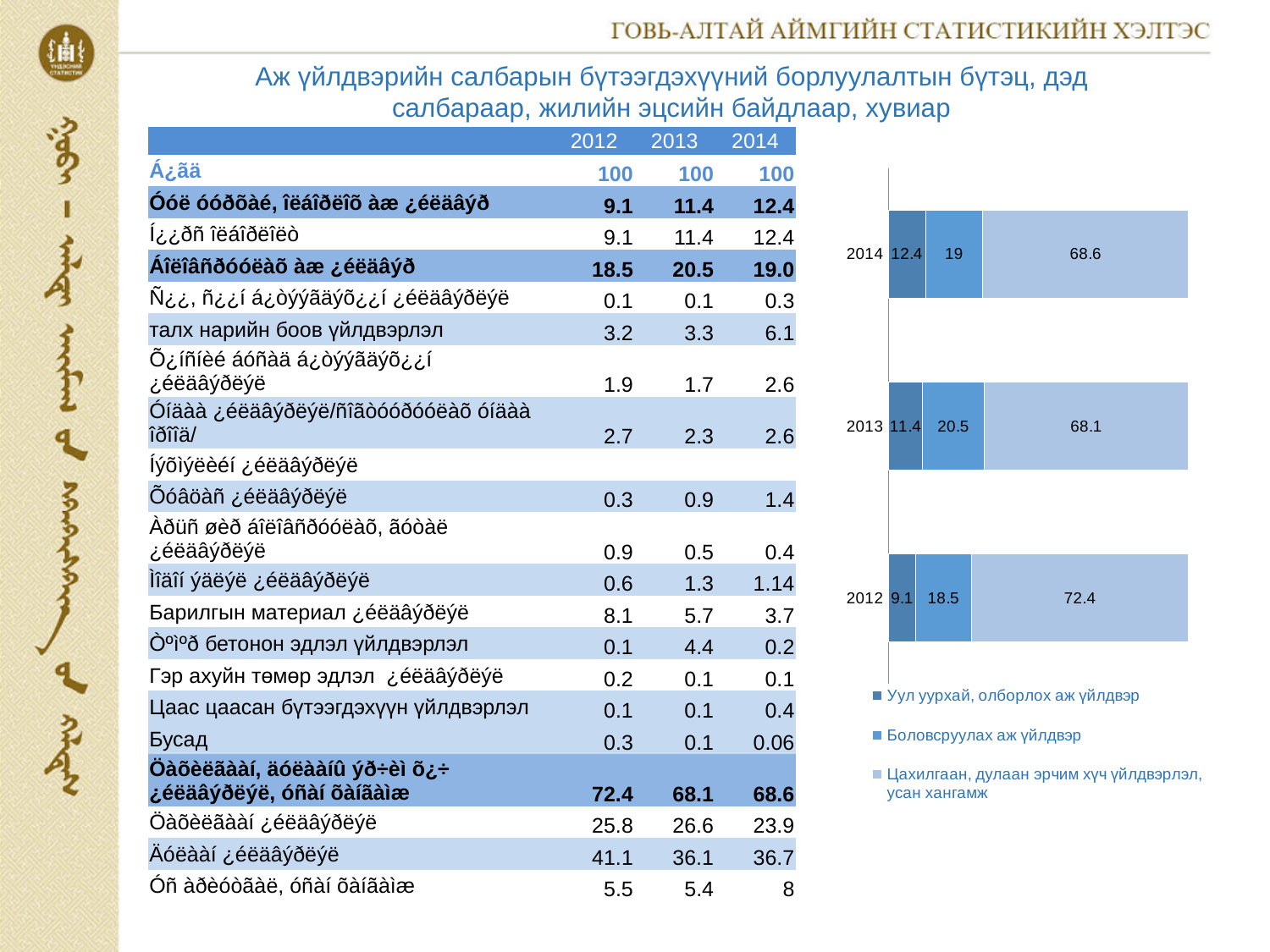
How many series does the legend of the bar chart list? 3 In the bar chart, what is the value for Цахилгаан, дулаан эрчим хүч үйлдвэрлэл, усан хангамж in 2012? 72.4 In the bar chart, which year has the highest value for Цахилгаан, дулаан эрчим хүч үйлдвэрлэл, усан хангамж? 2012 In the bar chart, what is the difference between the Боловсруулах аж үйлдвэр values for 2013 and 2012? 2 How many years are shown in the bar chart? 3 In the bar chart, what is the value for Уул уурхай, олборлох аж үйлдвэр in 2014? 12.4 In the bar chart, does the value for Уул уурхай, олборлох аж үйлдвэр rise or fall from 2012 to 2014? rise In the bar chart, what is the value for Боловсруулах аж үйлдвэр in 2013? 20.5 In the bar chart, is the Уул уурхай, олборлох аж үйлдвэр value larger in 2013 or in 2014? 2014 In the bar chart, what is the value for Боловсруулах аж үйлдвэр in 2014? 19 In the bar chart, which year has the lowest value for Уул уурхай, олборлох аж үйлдвэр? 2012 What kind of chart is shown on the right side of the slide? stacked bar chart